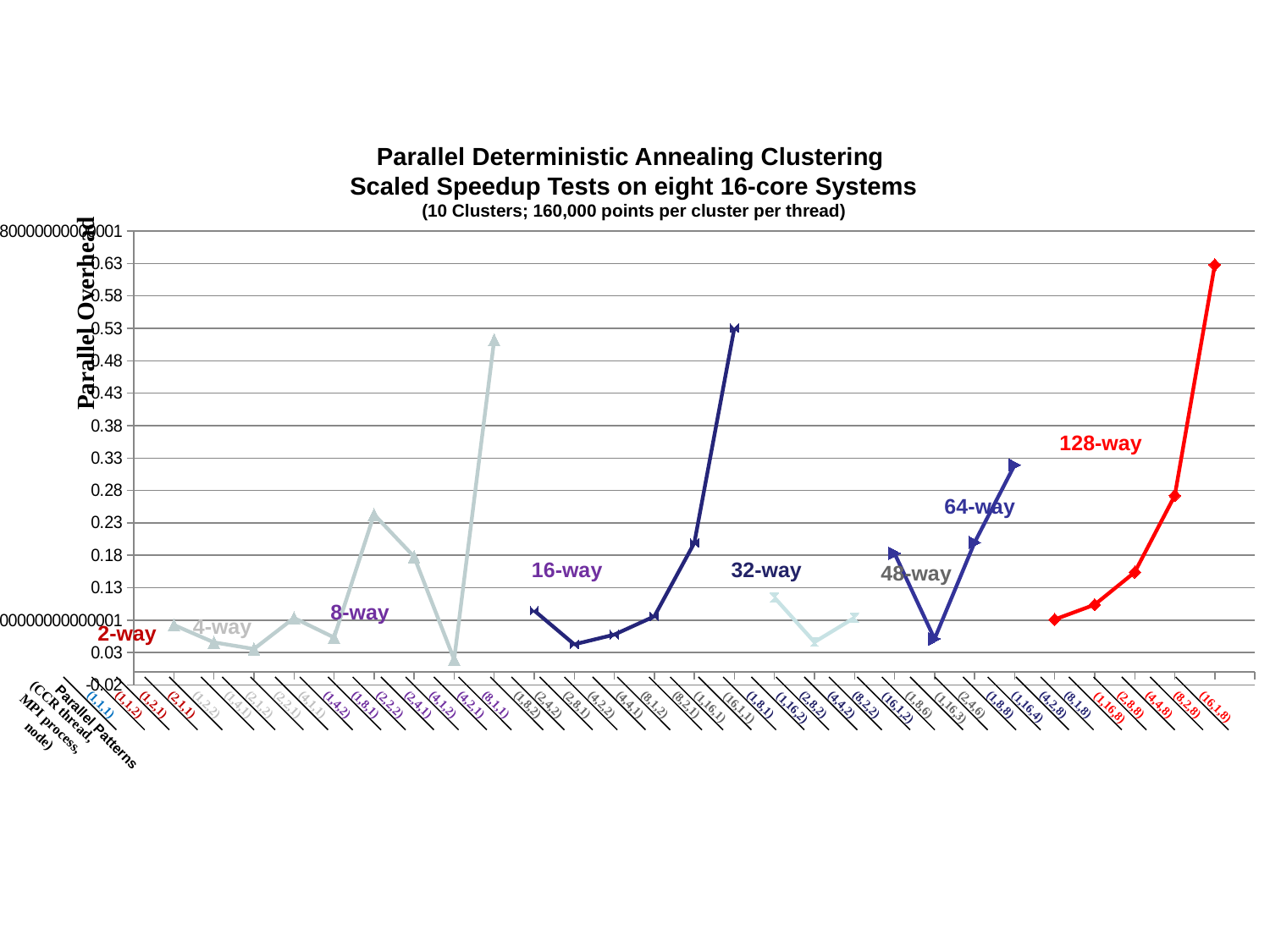
What is the label on the vertical axis of the chart? Parallel Overhead What kind of chart is shown on the slide? line chart What is the title of the chart? Parallel Deterministic Annealing Clustering Scaled Speedup Tests on eight 16-core Systems Is the value for the 8-way series at (8,1,1) greater or less than 0.43? greater Do the values of the 128-way series rise or fall moving left to right along the x axis? rise Which is larger: the peak value of the 128-way series or the peak value of the 16-way series? 128-way Is the value for the 16-way series at (16,1,1) greater or less than 0.48? greater Which series reaches the highest parallel overhead value on the chart? 128-way Is the value for the 64-way series at (1,16,4) greater or less than 0.38? less